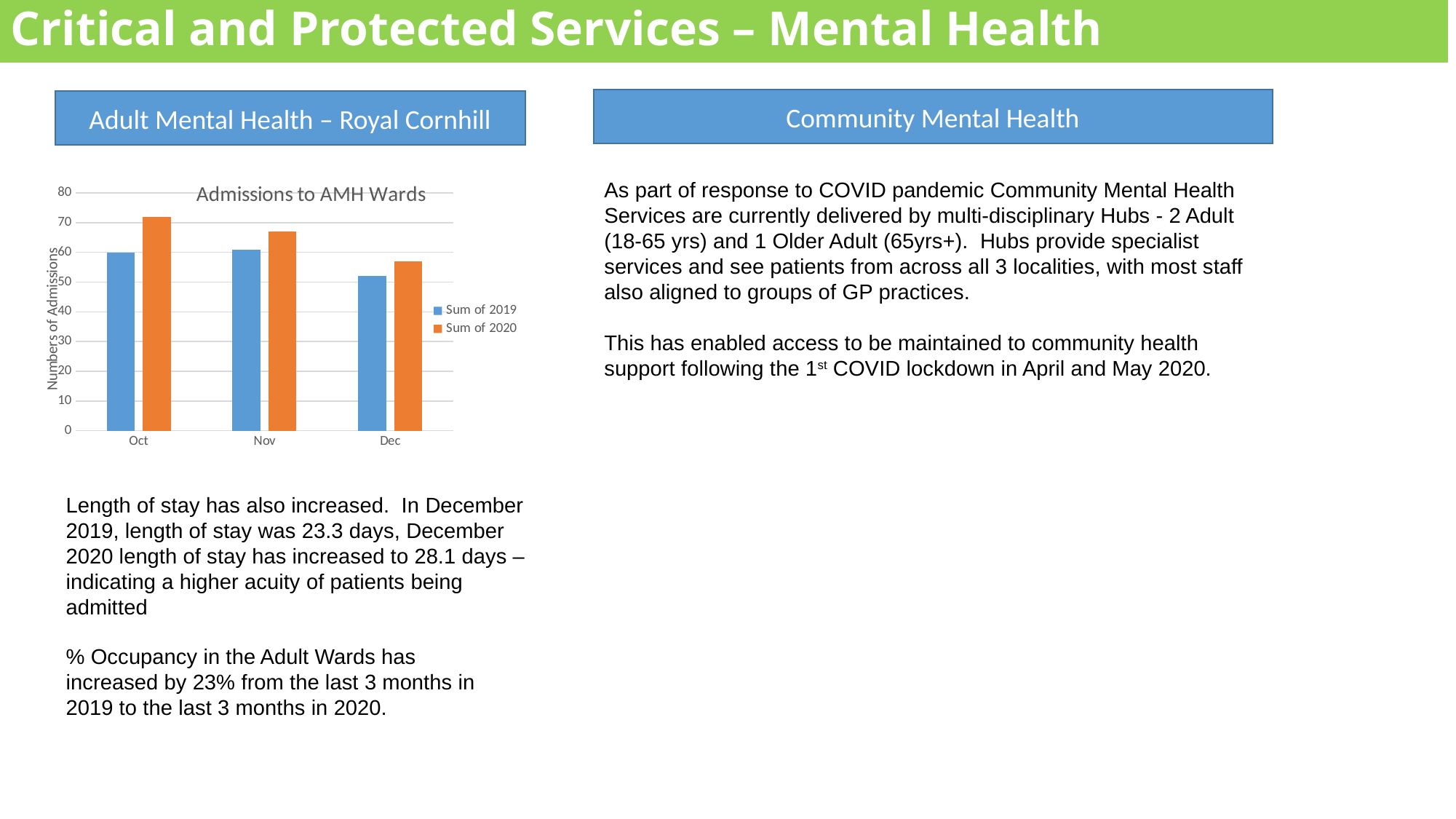
In the 'Admissions to AMH Wards' chart, is the Sum of 2020 value for Oct greater or less than 60? greater In the 'Admissions to AMH Wards' chart, which month has the lowest value for Sum of 2019? Dec In the 'Admissions to AMH Wards' chart, which series has the larger value for Dec, Sum of 2019 or Sum of 2020? Sum of 2020 How many series does the legend of the 'Admissions to AMH Wards' chart list? 2 How many months are shown on the x axis of the 'Admissions to AMH Wards' chart? 3 What is the title of the chart on the slide? Admissions to AMH Wards What kind of chart is 'Admissions to AMH Wards'? bar chart In the 'Admissions to AMH Wards' chart, which series has the larger value for Oct, Sum of 2019 or Sum of 2020? Sum of 2020 In the 'Admissions to AMH Wards' chart, is the Sum of 2019 value for Dec greater or less than 60? less What is the label on the vertical axis of the 'Admissions to AMH Wards' chart? Numbers of Admissions In the 'Admissions to AMH Wards' chart, do the Sum of 2020 values rise or fall from Oct to Dec? fall In the 'Admissions to AMH Wards' chart, which month has the highest value for Sum of 2020? Oct